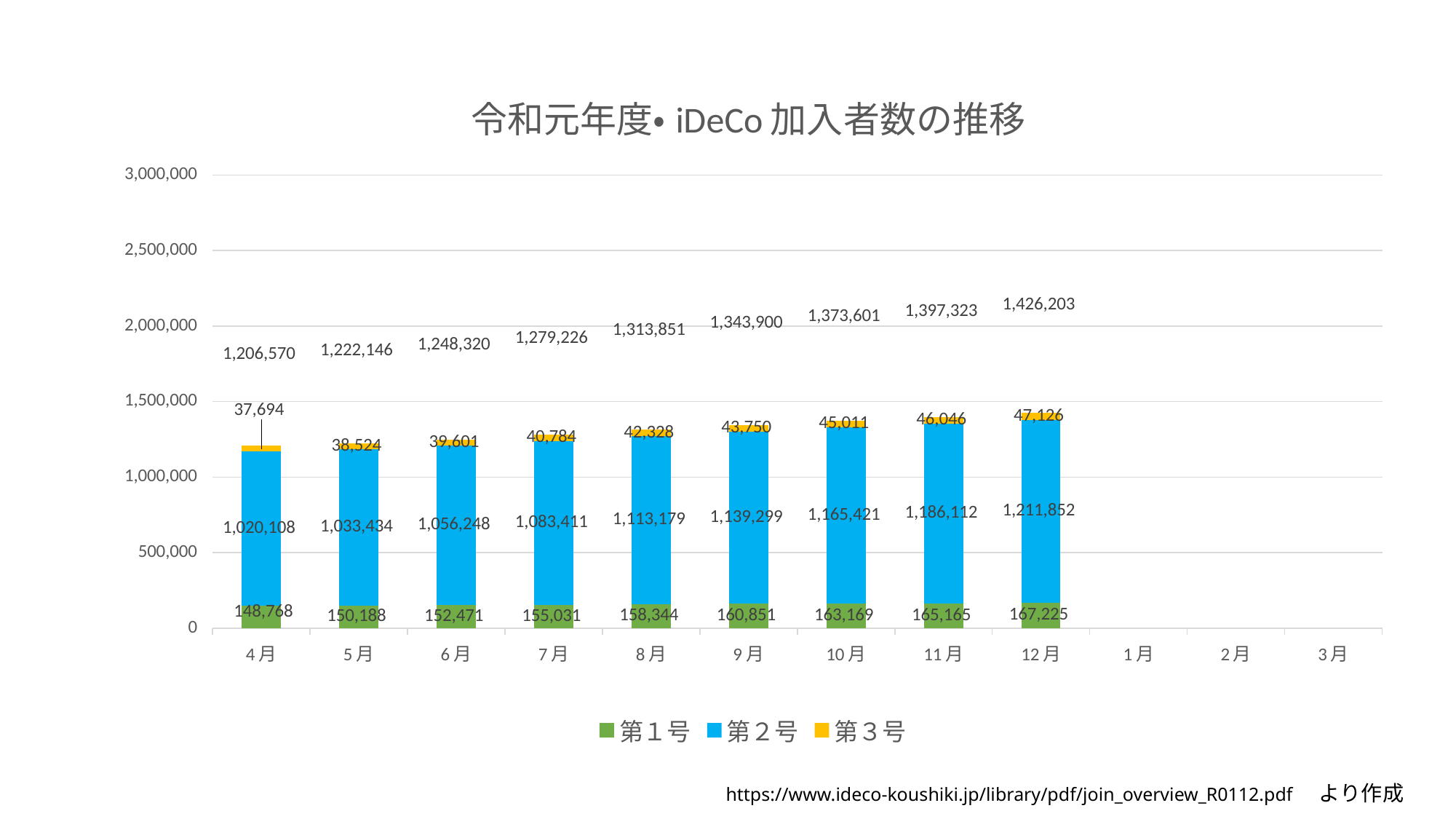
Which month has the highest total number of participants? 12月 What kind of chart is shown on the slide? stacked bar chart Is the total for 4月 greater or less than 1,500,000? less What is the total of the stacked bar for 9月? 1,343,900 How many series does the legend list? 3 Do the bar totals rise or fall from 4月 to 12月? rise Which is larger, the 第２号 value for 8月 or for 9月? 9月 What is the value of 第１号 for 12月? 167,225 What is the difference between the 第１号 value for 12月 and for 4月? 18,457 Which month has the lowest value for 第１号? 4月 What is the value of 第３号 for 4月? 37,694 What is the value of 第２号 for 7月? 1,083,411